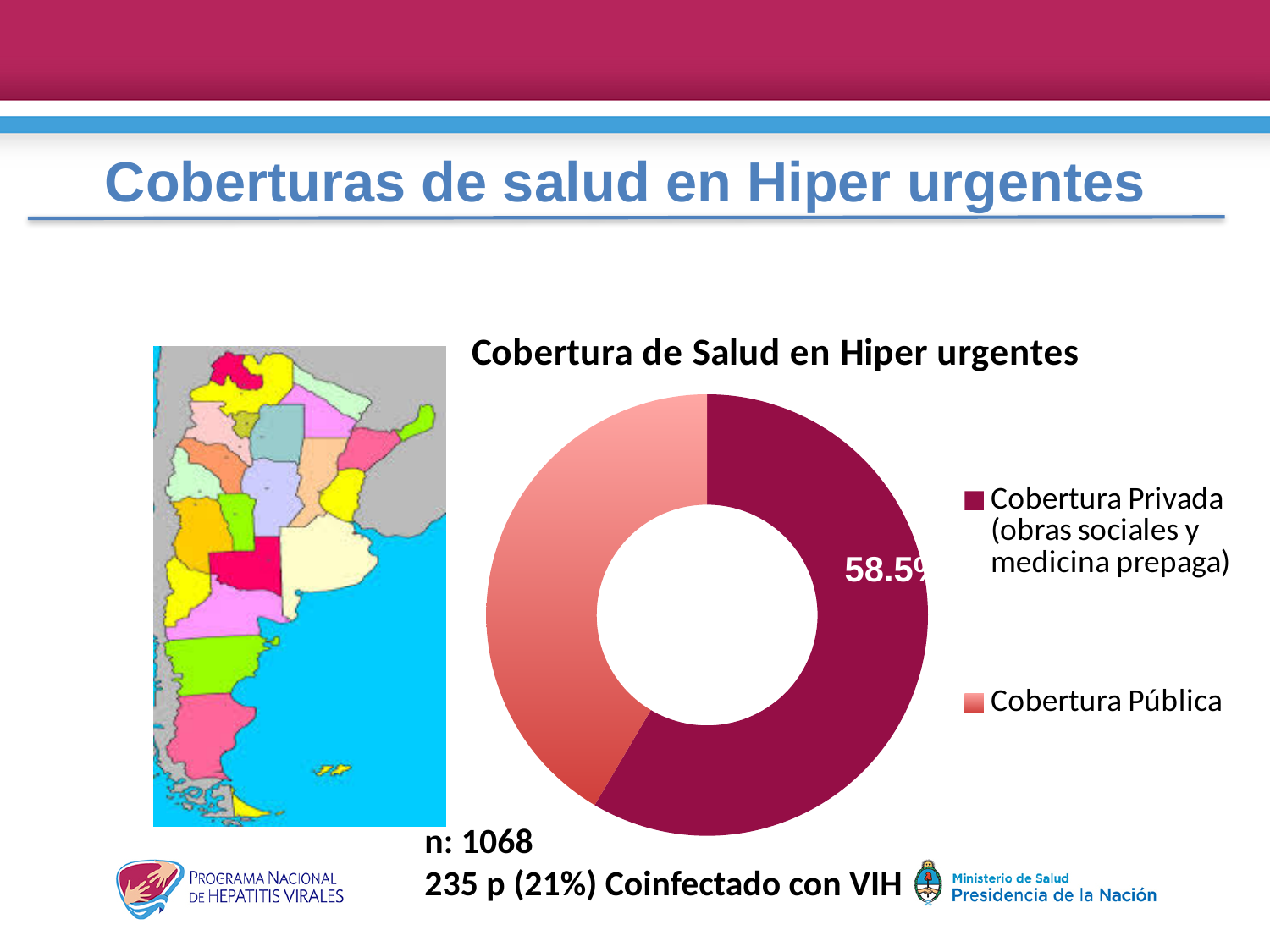
Which category has the smallest slice in the chart? Cobertura Pública What is the title of the chart? Cobertura de Salud en Hiper urgentes How many entries does the chart legend list? 2 Which is larger in the chart, Cobertura Privada or Cobertura Pública? Cobertura Privada Is the share for Cobertura Pública greater or less than 50%? less What share of the chart does Cobertura Privada represent? 58.5% Is the share for Cobertura Privada greater or less than 50%? greater What type of chart is shown under the title "Cobertura de Salud en Hiper urgentes"? Doughnut (pie) chart What percentage is shown for Cobertura Privada (obras sociales y medicina prepaga) in the chart? 58.5% Which category has the largest slice in the chart? Cobertura Privada (obras sociales y medicina prepaga) How many slices does the chart have? 2 Which legend entry is shown in the dark magenta colour? Cobertura Privada (obras sociales y medicina prepaga)